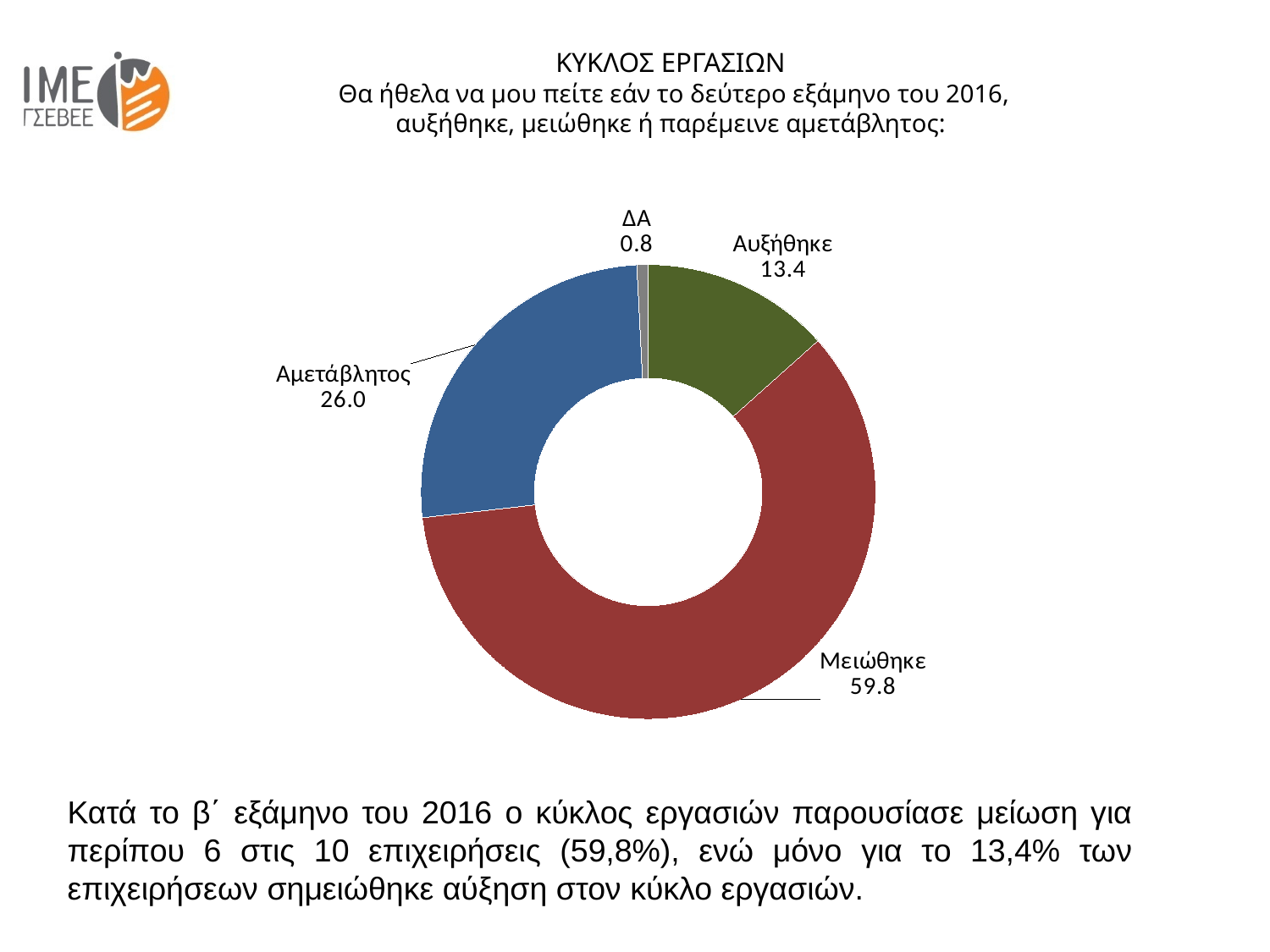
What value is shown for Μειώθηκε? 59.8 How many categories are shown in the chart? 4 What is the difference between the values for Μειώθηκε and Αμετάβλητος? 33.8 What value is shown for Αμετάβλητος? 26.0 What is the difference between the values for Αμετάβλητος and Αυξήθηκε? 12.6 What colour is the Μειώθηκε segment? Red What value is shown for Αυξήθηκε? 13.4 What value is shown for ΔΑ? 0.8 What kind of chart is shown on the slide? Doughnut chart Which category has the smallest share of the chart? ΔΑ Which category has the largest share of the chart? Μειώθηκε Which is larger, the value for Αυξήθηκε or the value for Αμετάβλητος? Αμετάβλητος